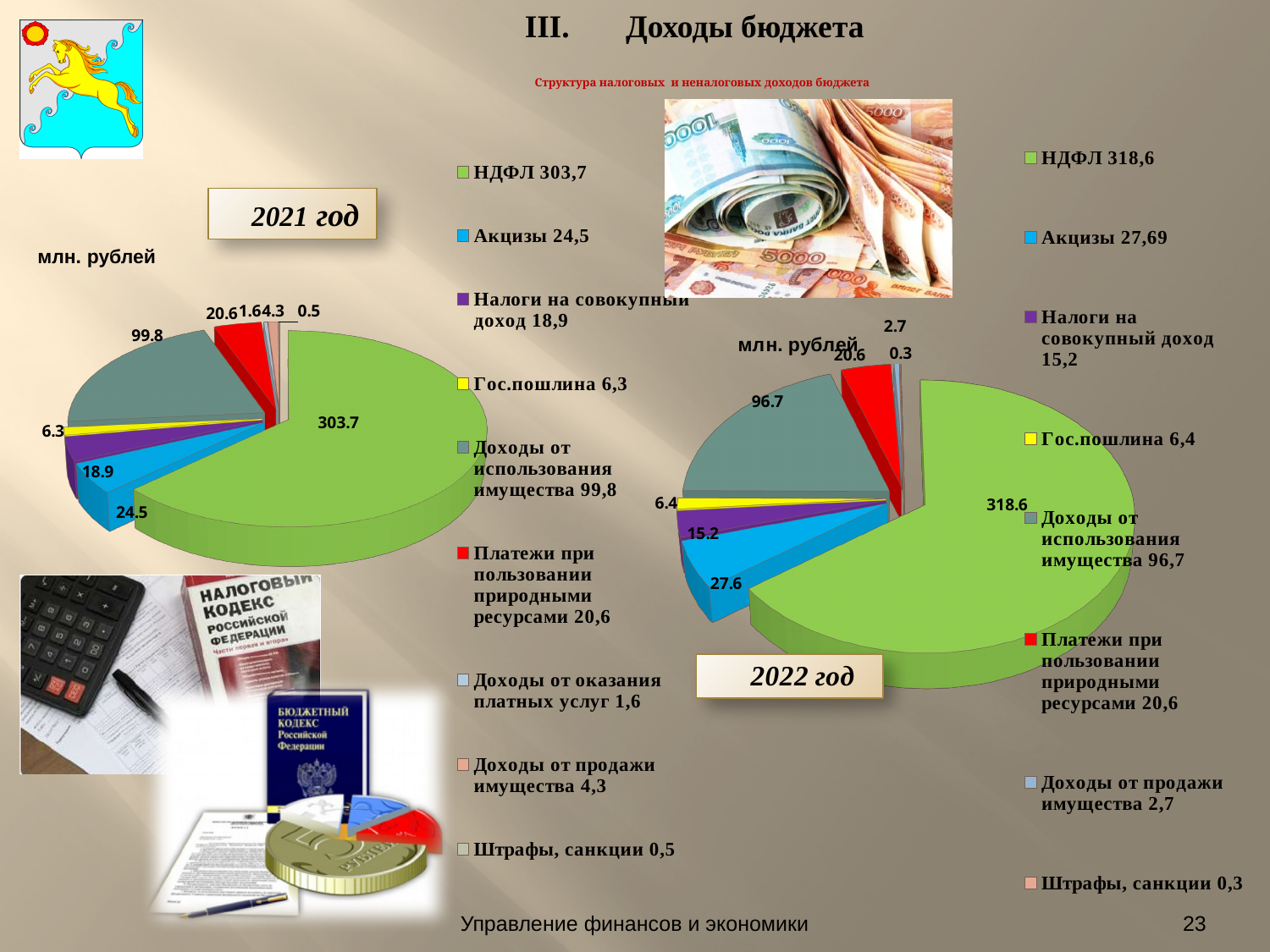
What type of chart is used for the 2022 год data? Pie chart On the 2022 год chart, what is the value for Доходы от использования имущества? 96.7 On the 2021 год chart, what is the value for НДФЛ? 303.7 On the 2022 год chart, which category has the smallest value? Штрафы, санкции On the 2021 год chart, which category has the smallest value? Штрафы, санкции On the 2021 год chart, which is larger: Акцизы or Платежи при пользовании природными ресурсами? Акцизы What is the difference between the НДФЛ value on the 2022 год chart and the НДФЛ value on the 2021 год chart? 14.9 How many categories does the 2022 год chart show? 8 How many categories does the 2021 год chart show? 9 On the 2021 год chart, what is the value for Налоги на совокупный доход? 18.9 On the 2022 год chart, which category has the largest slice? НДФЛ On the 2021 год chart, what is the difference between НДФЛ and Доходы от использования имущества? 203.9